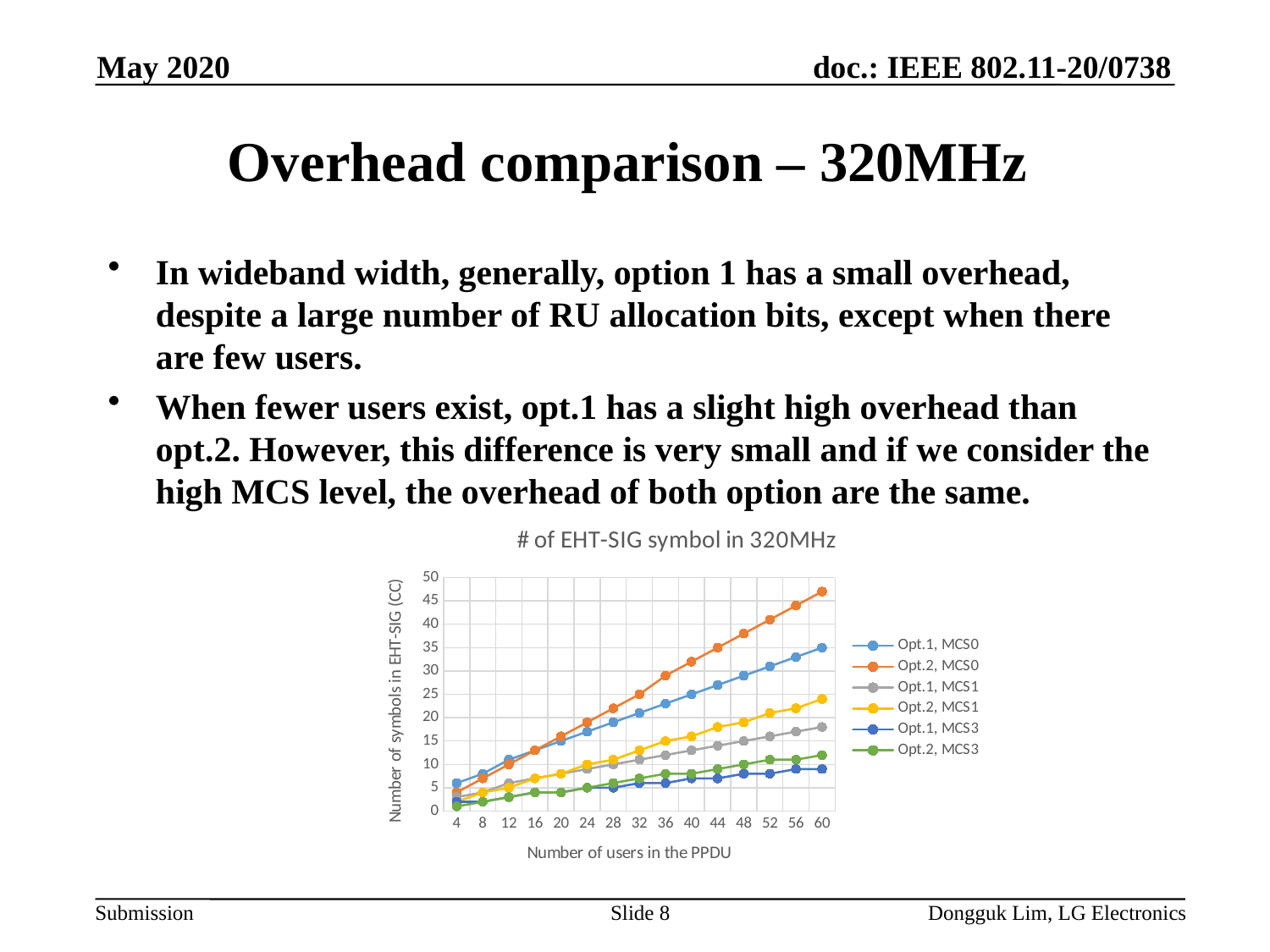
Which series has the lowest value at 60 users in the PPDU? Opt.1, MCS3 Is the value for Opt.2, MCS0 at 60 users greater or less than 45? greater Is the value for Opt.2, MCS3 at 60 users greater or less than 10? greater How many series does the chart legend list? 6 At 60 users in the PPDU, which is larger: Opt.2, MCS0 or Opt.1, MCS0? Opt.2, MCS0 How many values of 'Number of users in the PPDU' are plotted along the x axis? 15 What type of chart is shown on the slide? line chart Is the value for Opt.1, MCS1 at 60 users greater or less than 20? less Do the values for Opt.2, MCS0 rise or fall as the number of users in the PPDU increases? rise What is the title of the chart? # of EHT-SIG symbol in 320MHz Which series has the highest value at 60 users in the PPDU? Opt.2, MCS0